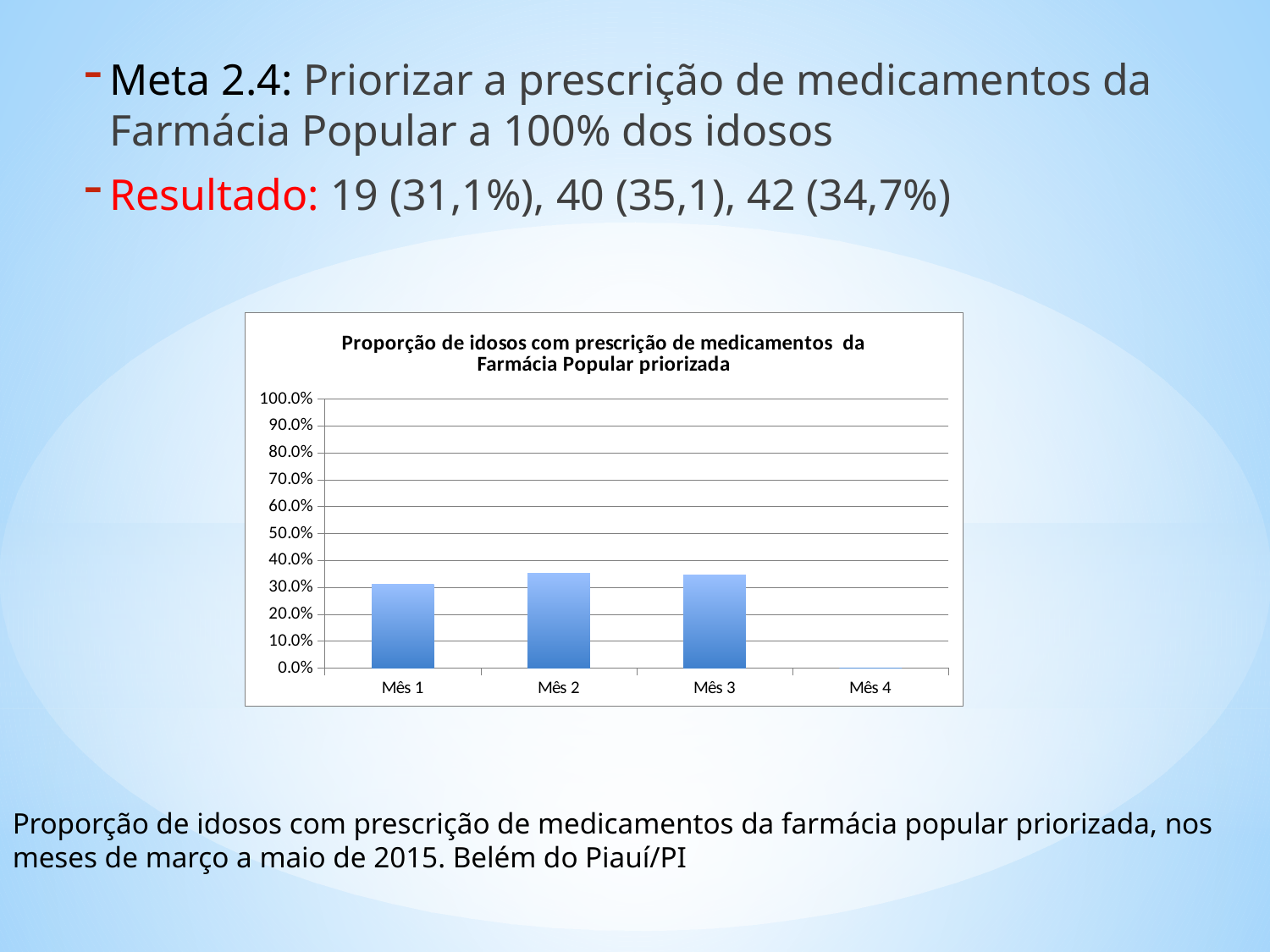
Is the value for Mês 2 greater or less than 30%? greater Is the value for Mês 1 greater or less than 20%? greater What kind of chart is shown on the slide? bar chart Does the value rise or fall from Mês 1 to Mês 2? rise How many categories are shown on the x axis of the chart? 4 Which category on the x axis has no bar plotted? Mês 4 Among the months with a plotted bar, which has the lowest value? Mês 1 Is the value for Mês 1 greater or less than 40%? less What is the title of the chart? Proporção de idosos com prescrição de medicamentos da Farmácia Popular priorizada Which is larger, the value for Mês 1 or the value for Mês 2? Mês 2